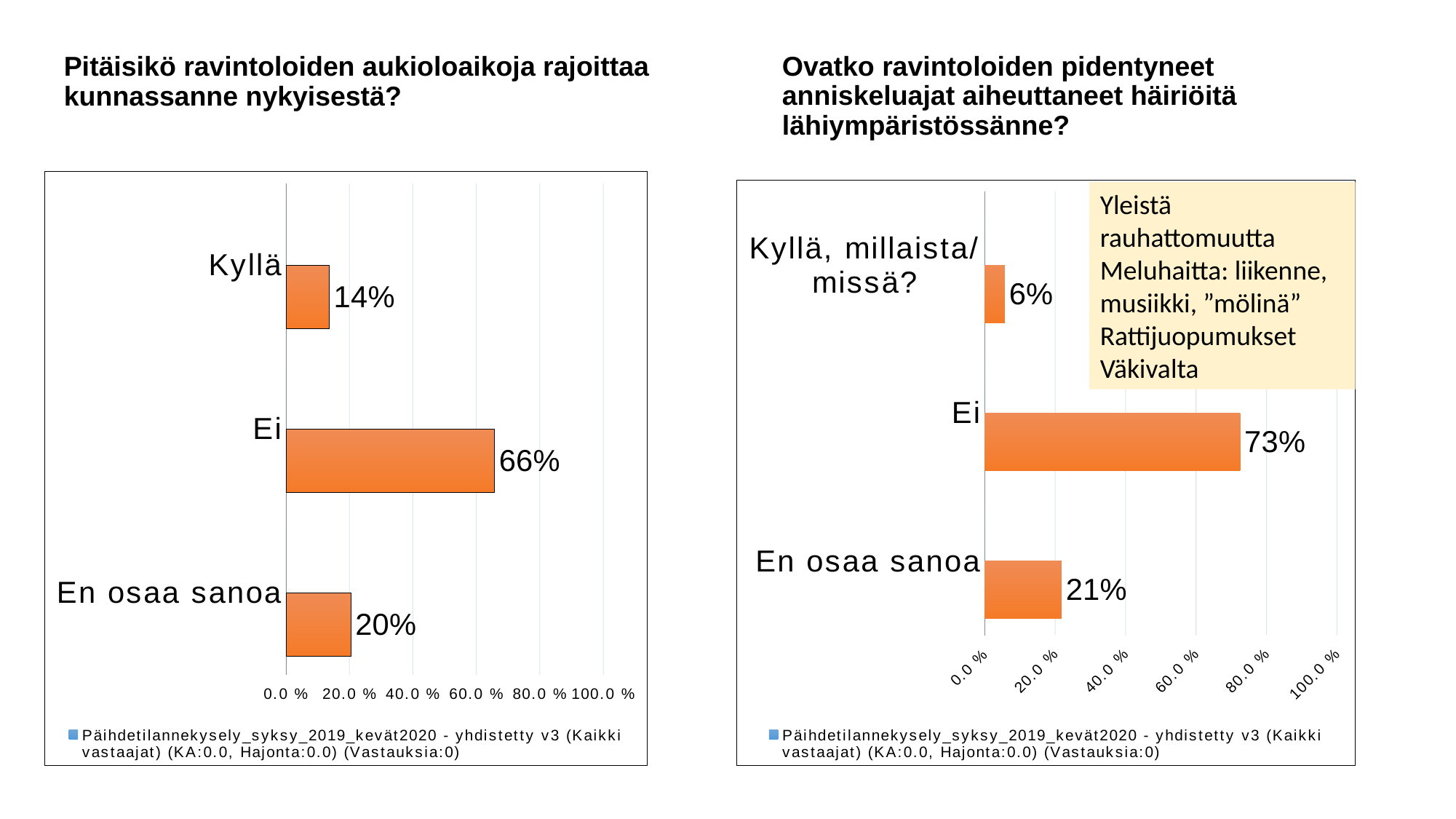
What kind of chart is the left chart (Pitäisikö ravintoloiden aukioloaikoja rajoittaa kunnassanne nykyisestä?)? Bar chart In the right chart (Ovatko ravintoloiden pidentyneet anniskeluajat aiheuttaneet häiriöitä lähiympäristössänne?), what is the value for En osaa sanoa? 21% In the right chart (Ovatko ravintoloiden pidentyneet anniskeluajat aiheuttaneet häiriöitä lähiympäristössänne?), what is the value for Ei? 73% In the right chart (Ovatko ravintoloiden pidentyneet anniskeluajat aiheuttaneet häiriöitä lähiympäristössänne?), which is larger: En osaa sanoa or Kyllä, millaista/missä? En osaa sanoa In the left chart (Pitäisikö ravintoloiden aukioloaikoja rajoittaa kunnassanne nykyisestä?), which category has the highest value? Ei In the right chart (Ovatko ravintoloiden pidentyneet anniskeluajat aiheuttaneet häiriöitä lähiympäristössänne?), what is the difference between Ei and Kyllä, millaista/missä? 67% In the left chart (Pitäisikö ravintoloiden aukioloaikoja rajoittaa kunnassanne nykyisestä?), what is the difference between Ei and En osaa sanoa? 46% In the left chart (Pitäisikö ravintoloiden aukioloaikoja rajoittaa kunnassanne nykyisestä?), which category has the lowest value? Kyllä In the right chart (Ovatko ravintoloiden pidentyneet anniskeluajat aiheuttaneet häiriöitä lähiympäristössänne?), which category has the lowest value? Kyllä, millaista/missä? In the left chart (Pitäisikö ravintoloiden aukioloaikoja rajoittaa kunnassanne nykyisestä?), what is the value for Kyllä? 14% In the left chart (Pitäisikö ravintoloiden aukioloaikoja rajoittaa kunnassanne nykyisestä?), how many categories are shown? 3 In the left chart (Pitäisikö ravintoloiden aukioloaikoja rajoittaa kunnassanne nykyisestä?), what is the value for Ei? 66%